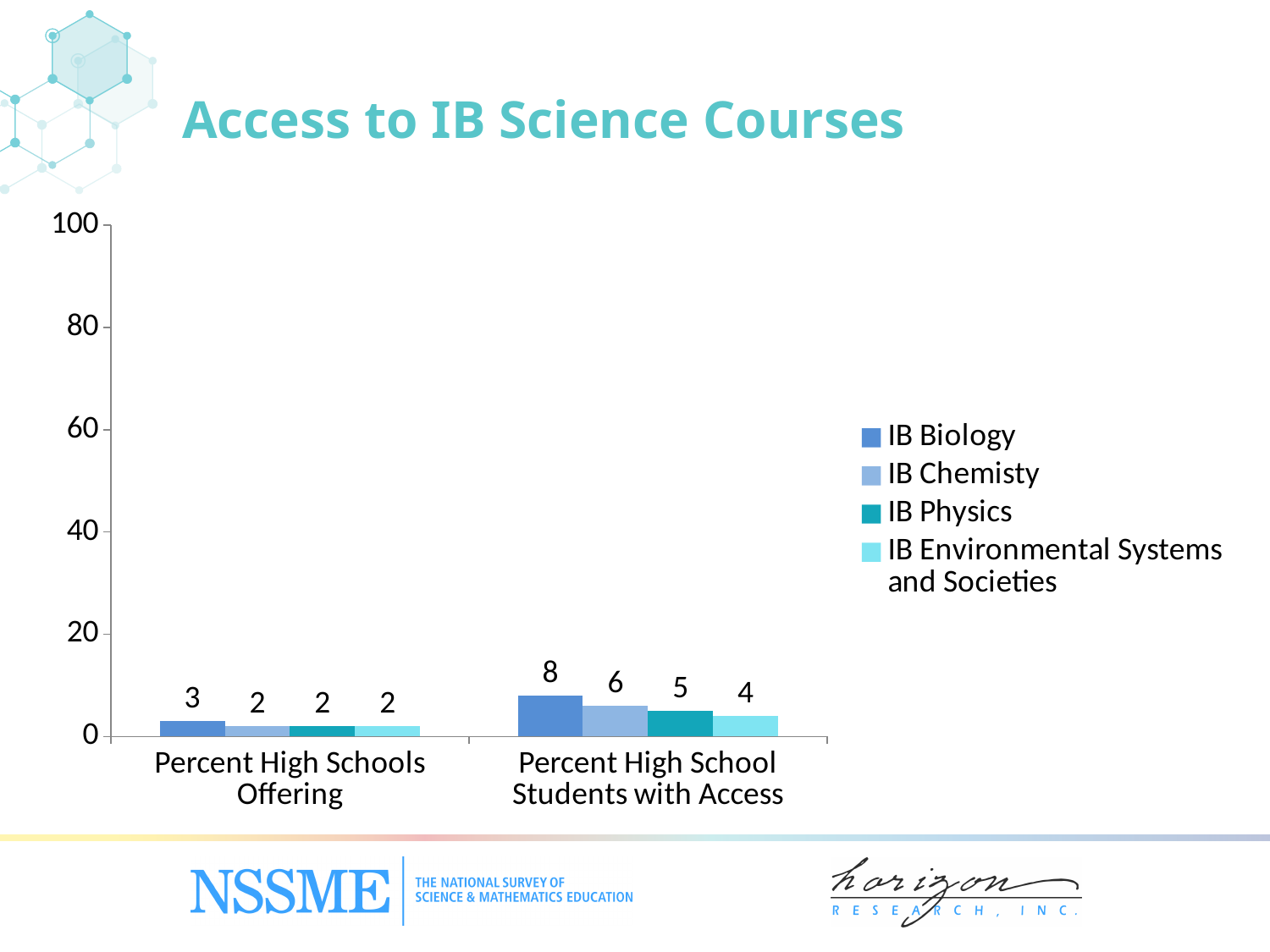
What is the value for IB Biology in the Percent High Schools Offering category? 3 Which series has the lowest value in the Percent High School Students with Access category? IB Environmental Systems and Societies What is the value for IB Physics in the Percent High School Students with Access category? 5 What is the title of the chart? Access to IB Science Courses What is the difference between the IB Biology value and the IB Environmental Systems and Societies value in the Percent High School Students with Access category? 4 Which is larger: the IB Chemisty value for Percent High Schools Offering or the IB Chemisty value for Percent High School Students with Access? Percent High School Students with Access What kind of chart is shown on the slide? bar chart Is the value for IB Biology in the Percent High School Students with Access category greater or less than 20? less Which series has the highest value in the Percent High School Students with Access category? IB Biology What is the value for IB Environmental Systems and Societies in the Percent High School Students with Access category? 4 How many series does the legend list? 4 What is the value for IB Chemisty in the Percent High Schools Offering category? 2